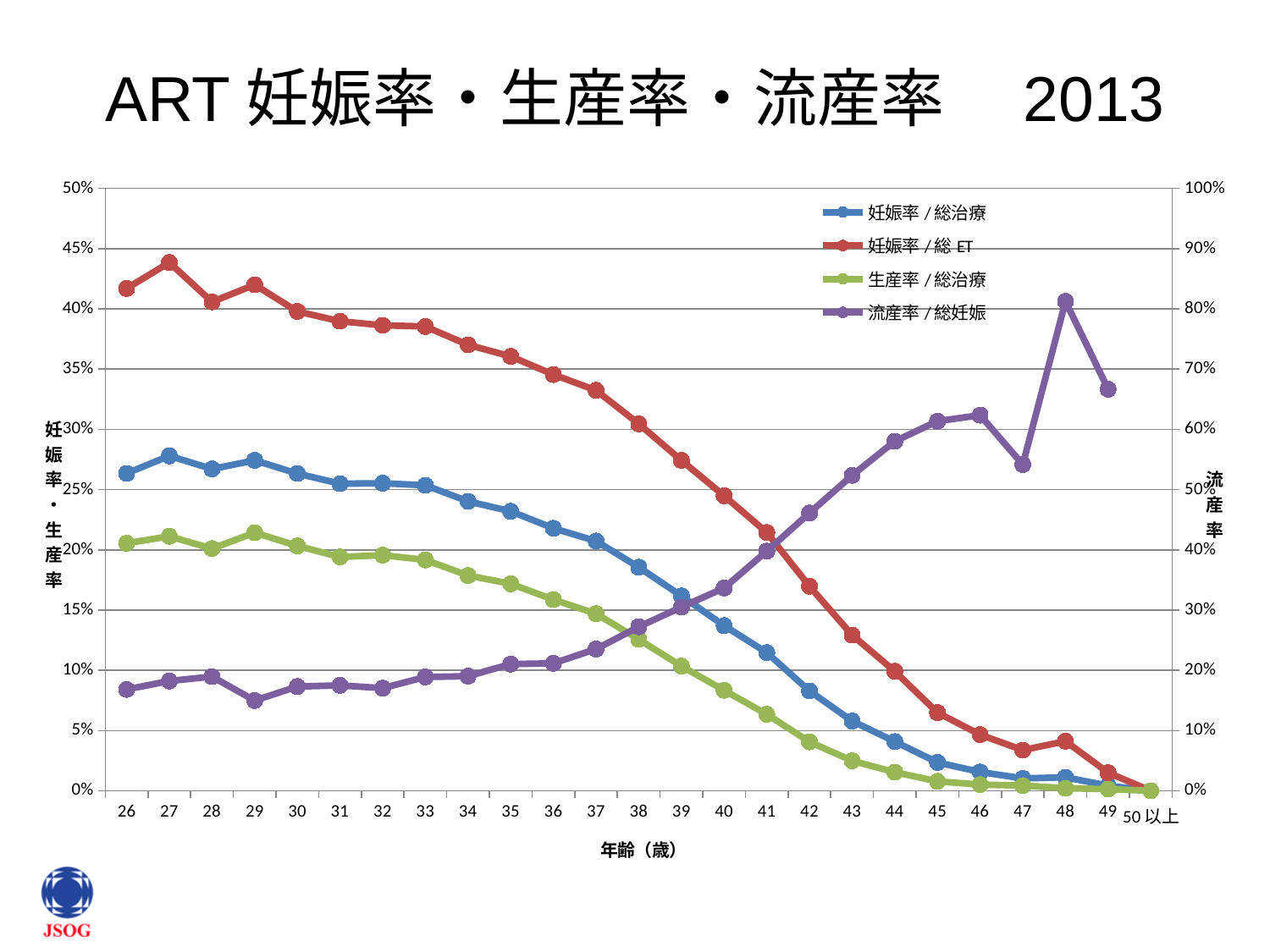
Does the 妊娠率 / 総治療 series rise or fall as age increases along the x axis? fall At which age is the 流産率 / 総妊娠 series highest? 48 What colour is the 流産率 / 総妊娠 line in the legend? purple At age 40, which is larger: 妊娠率 / 総 ET or 生産率 / 総治療? 妊娠率 / 総 ET Is the value of 流産率 / 総妊娠 at age 48 greater or less than 70% on the right axis? greater How many age categories are plotted along the x axis? 25 At which age is the 妊娠率 / 総 ET series highest? 27 How many series does the legend list? 4 Does the 流産率 / 総妊娠 series generally rise or fall as age increases from 26 to 48? rise What kind of chart is shown on the slide? line chart Is the value of 生産率 / 総治療 at age 40 greater or less than 10%? less Is the value of 妊娠率 / 総 ET at age 26 greater or less than 40%? greater